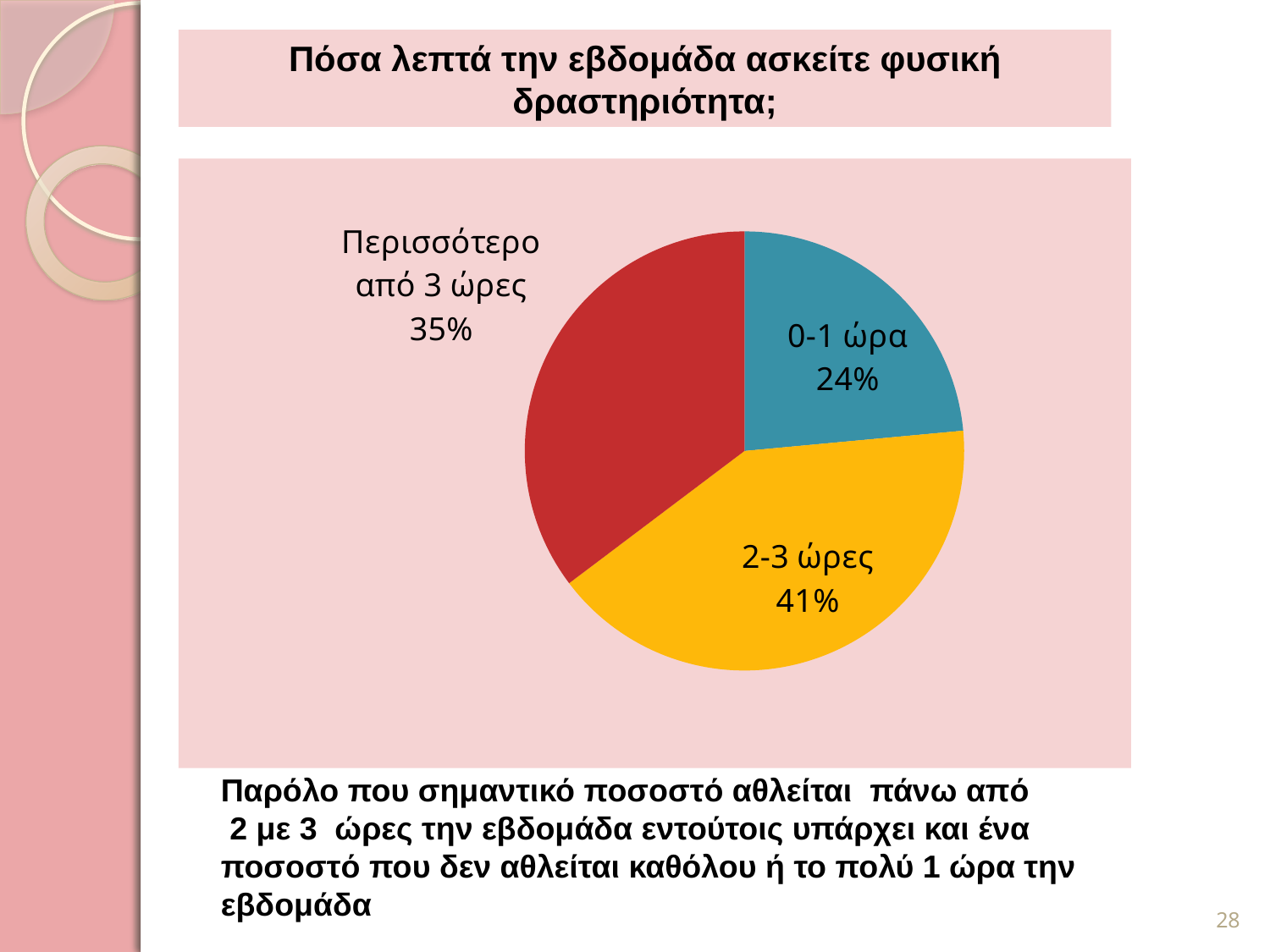
What is the difference in percentage points between '2-3 ώρες' and 'Περισσότερο από 3 ώρες'? 6 Which is larger, the share for 'Περισσότερο από 3 ώρες' or the share for '0-1 ώρα'? Περισσότερο από 3 ώρες What percentage is shown for the 'Περισσότερο από 3 ώρες' slice? 35% What kind of chart is shown on the slide? Pie chart Which category has the largest share of the pie? 2-3 ώρες What percentage is shown for the '2-3 ώρες' slice? 41% How many slices does the pie chart have? 3 Which category has the smallest share of the pie? 0-1 ώρα What percentage is shown for the '0-1 ώρα' slice? 24% What is the title of the chart on the slide? Πόσα λεπτά την εβδομάδα ασκείτε φυσική δραστηριότητα; What is the difference in percentage points between '2-3 ώρες' and '0-1 ώρα'? 17 What colour is the '2-3 ώρες' slice? Yellow